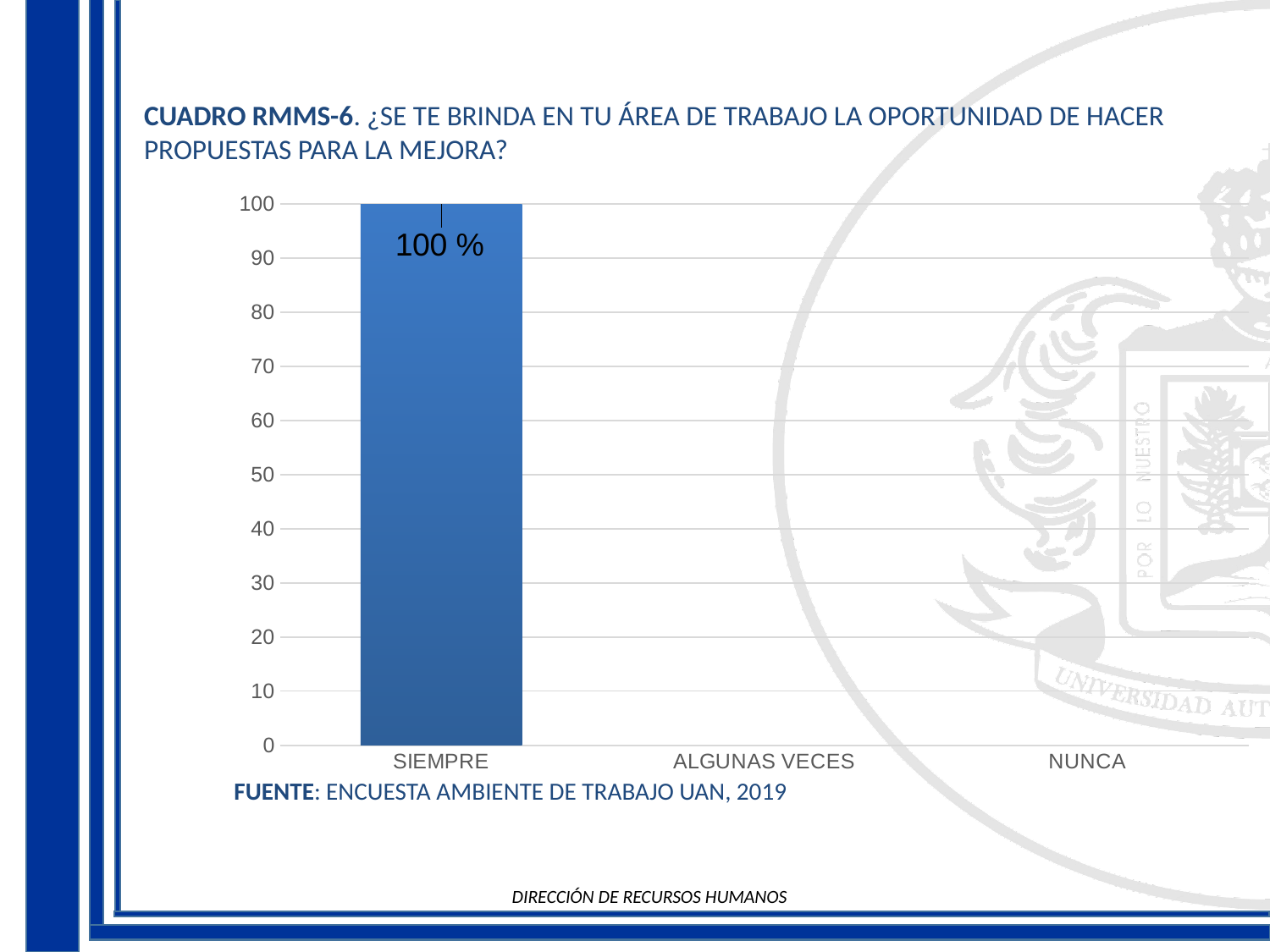
What is the value shown for SIEMPRE? 100 % What is the highest value shown on the y axis? 100 What is the source cited below the chart? ENCUESTA AMBIENTE DE TRABAJO UAN, 2019 Which category has the highest value? SIEMPRE Is the value for SIEMPRE greater or less than 50? greater Which is larger, the value for SIEMPRE or the value for NUNCA? SIEMPRE What kind of chart is shown on the slide? bar chart Which is larger, the value for SIEMPRE or the value for ALGUNAS VECES? SIEMPRE How many categories are shown on the x axis? 3 Which category is listed last on the x axis? NUNCA